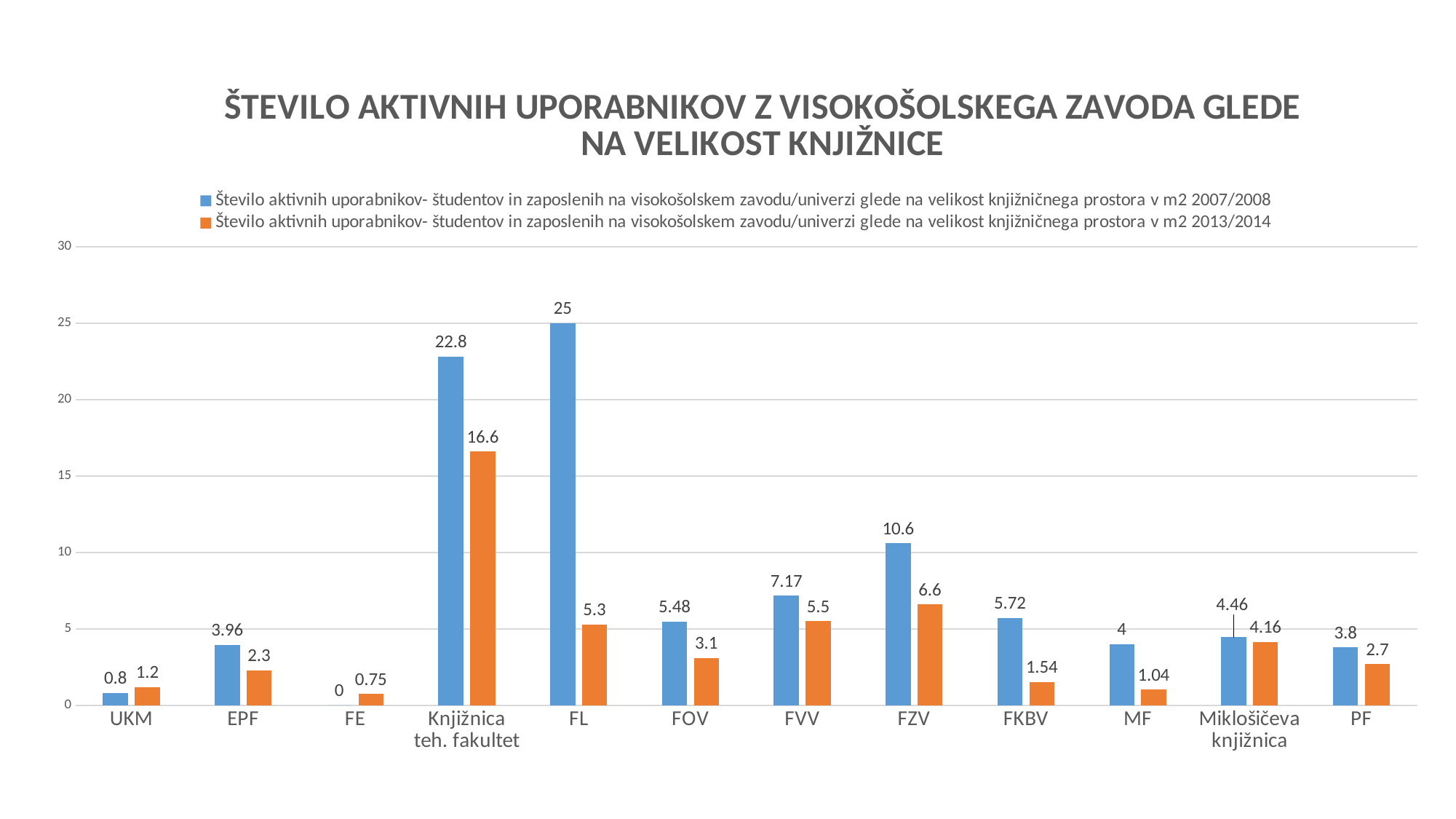
Which category has the lowest 2013/2014 value? FE Which is larger for UKM: the 2007/2008 value or the 2013/2014 value? 2013/2014 What is the 2007/2008 value for FL? 25 Is the 2007/2008 value for Knjižnica teh. fakultet greater or less than 20? greater How many categories are shown on the x axis? 12 What kind of chart is shown on the slide? bar chart How many series does the legend list? 2 Which category has the highest 2007/2008 value? FL What is the 2013/2014 value for FKBV? 1.54 What colour represents the 2013/2014 series? orange What is the 2013/2014 value for Knjižnica teh. fakultet? 16.6 What is the difference between the 2007/2008 and 2013/2014 values for FZV? 4